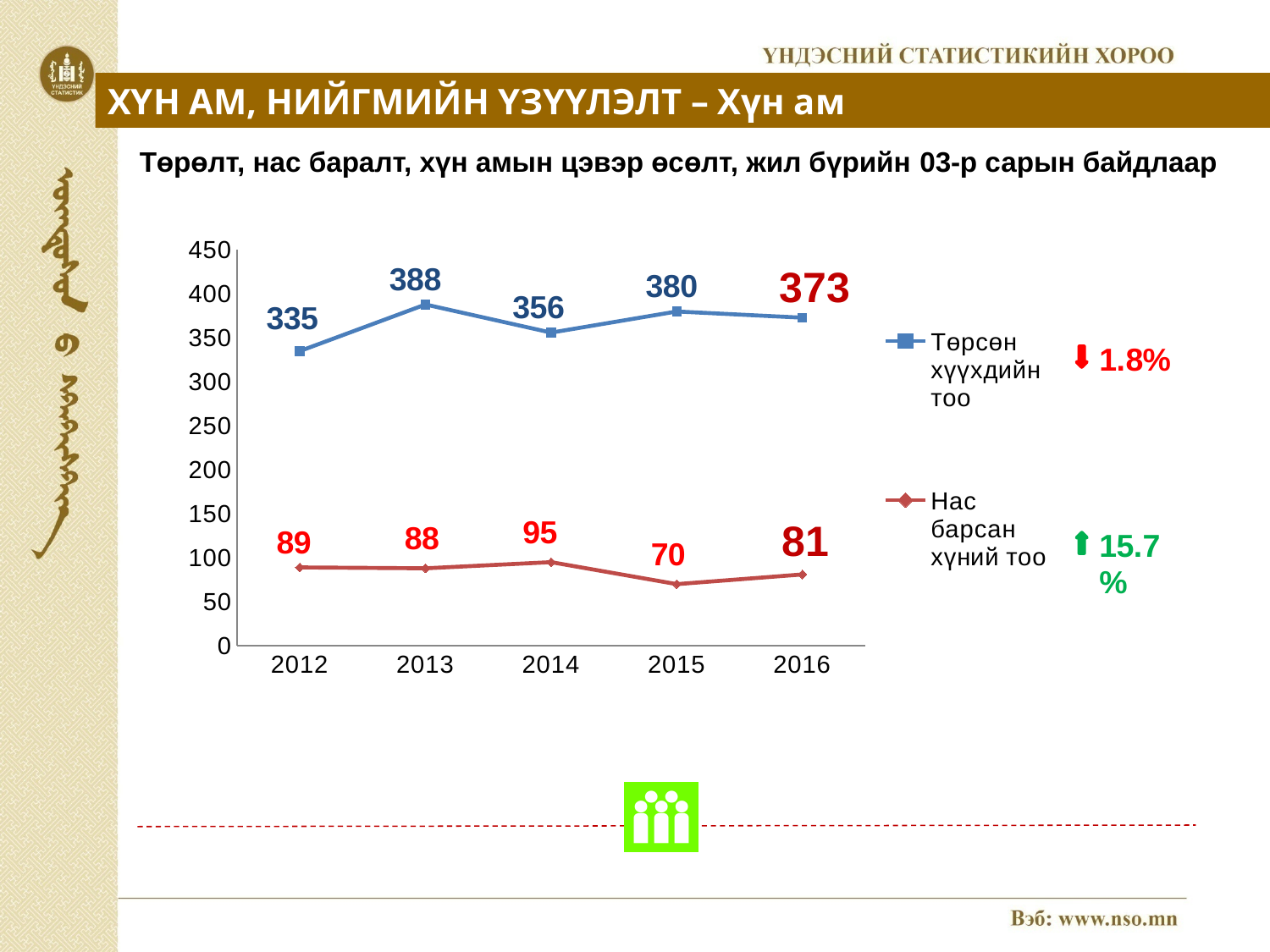
What is the difference between Төрсөн хүүхдийн тоо in 2013 and in 2012? 53 What kind of chart is shown on the slide? line chart What is the value of Төрсөн хүүхдийн тоо in 2013? 388 In which year is Төрсөн хүүхдийн тоо highest? 2013 How many series does the legend list? 2 In which year is Нас барсан хүний тоо lowest? 2015 Is the value of Төрсөн хүүхдийн тоо in 2012 greater or less than 300? greater What is the difference between Нас барсан хүний тоо in 2014 and in 2015? 25 What is the value of Нас барсан хүний тоо in 2015? 70 What is the value of Төрсөн хүүхдийн тоо in 2016? 373 Which is larger: Төрсөн хүүхдийн тоо in 2015 or in 2016? 2015 How many years are shown on the x axis? 5